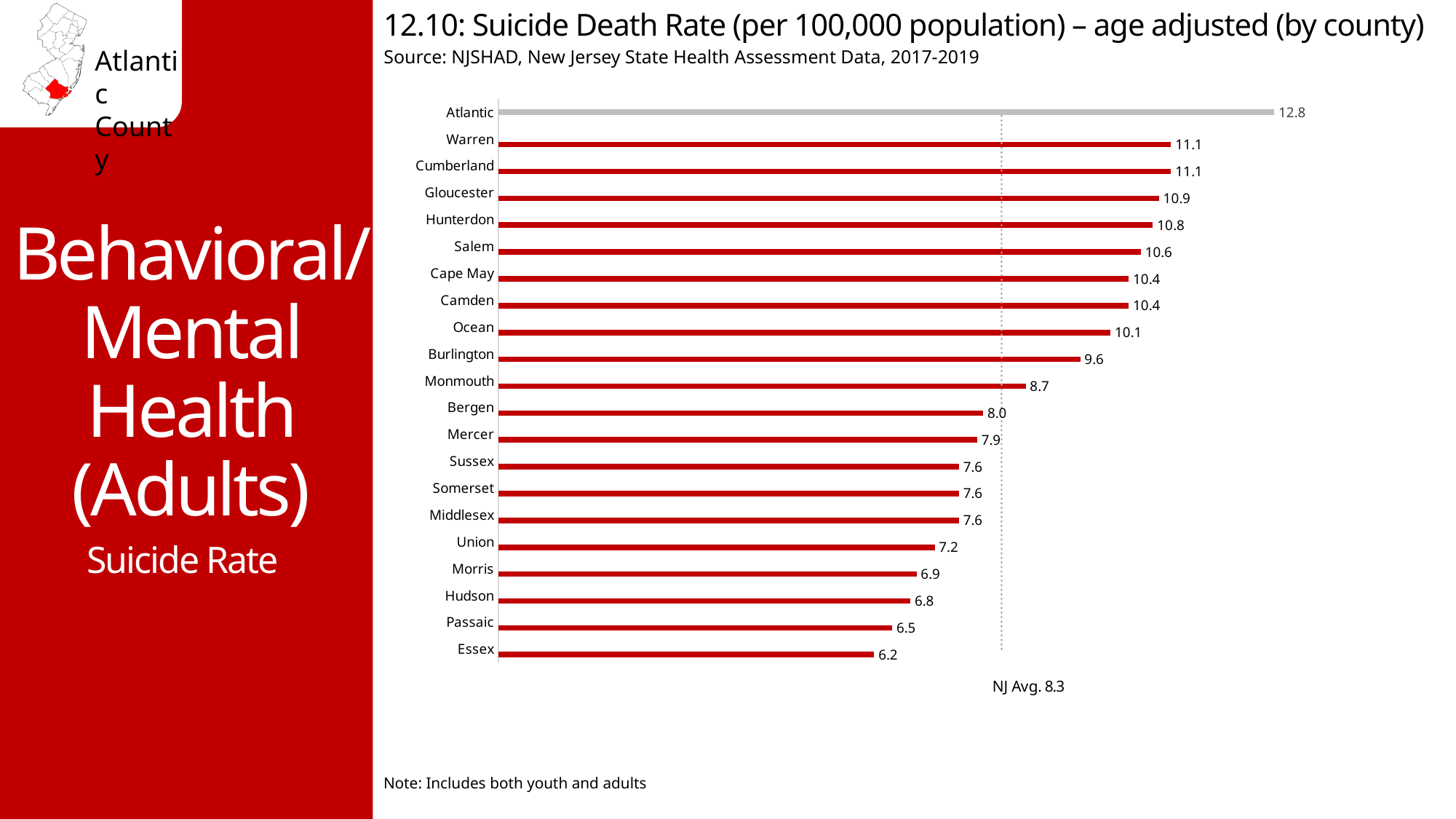
Which county has a higher suicide death rate, Ocean or Bergen? Ocean What is the suicide death rate for Burlington County? 9.6 What is the suicide death rate for Atlantic County? 12.8 Which county has the highest suicide death rate? Atlantic Which county has the lowest suicide death rate? Essex What is the NJ average suicide death rate marked on the chart? 8.3 What is the suicide death rate for Essex County? 6.2 What is the difference between the suicide death rates of Atlantic and Essex counties? 6.6 What kind of chart is shown on the slide? Bar chart What is the suicide death rate for Hudson County? 6.8 How many counties are shown in the chart? 21 What is the difference between the suicide death rates of Gloucester and Monmouth counties? 2.2